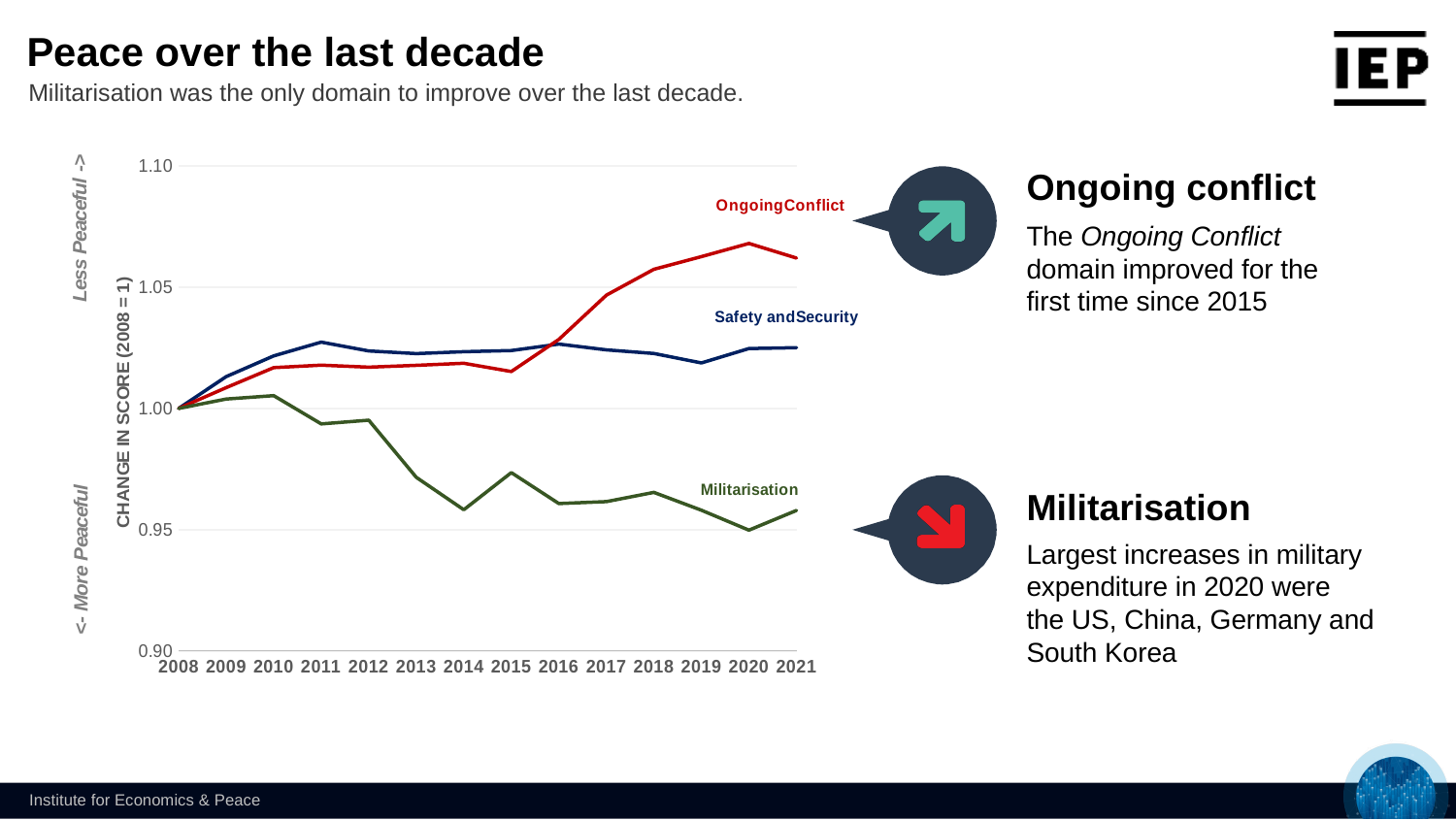
Which series has the lowest value in 2021? Militarisation What is the value of the Militarisation series in 2008? 1.00 Is the value for Ongoing Conflict in 2020 greater or less than 1.05? greater Is the value for Safety and Security in 2021 greater or less than 1.00? greater What kind of chart is shown on the slide? line chart How many series are plotted on the chart? 3 Which series has the highest value in 2021? Ongoing Conflict Does the Militarisation series rise or fall from 2008 to 2021? fall How many years are shown along the x axis of the chart? 14 Is the value for Militarisation in 2014 greater or less than 1.00? less What is the label on the y axis of the chart? CHANGE IN SCORE (2008 = 1) In 2021, which is larger: Ongoing Conflict or Safety and Security? Ongoing Conflict